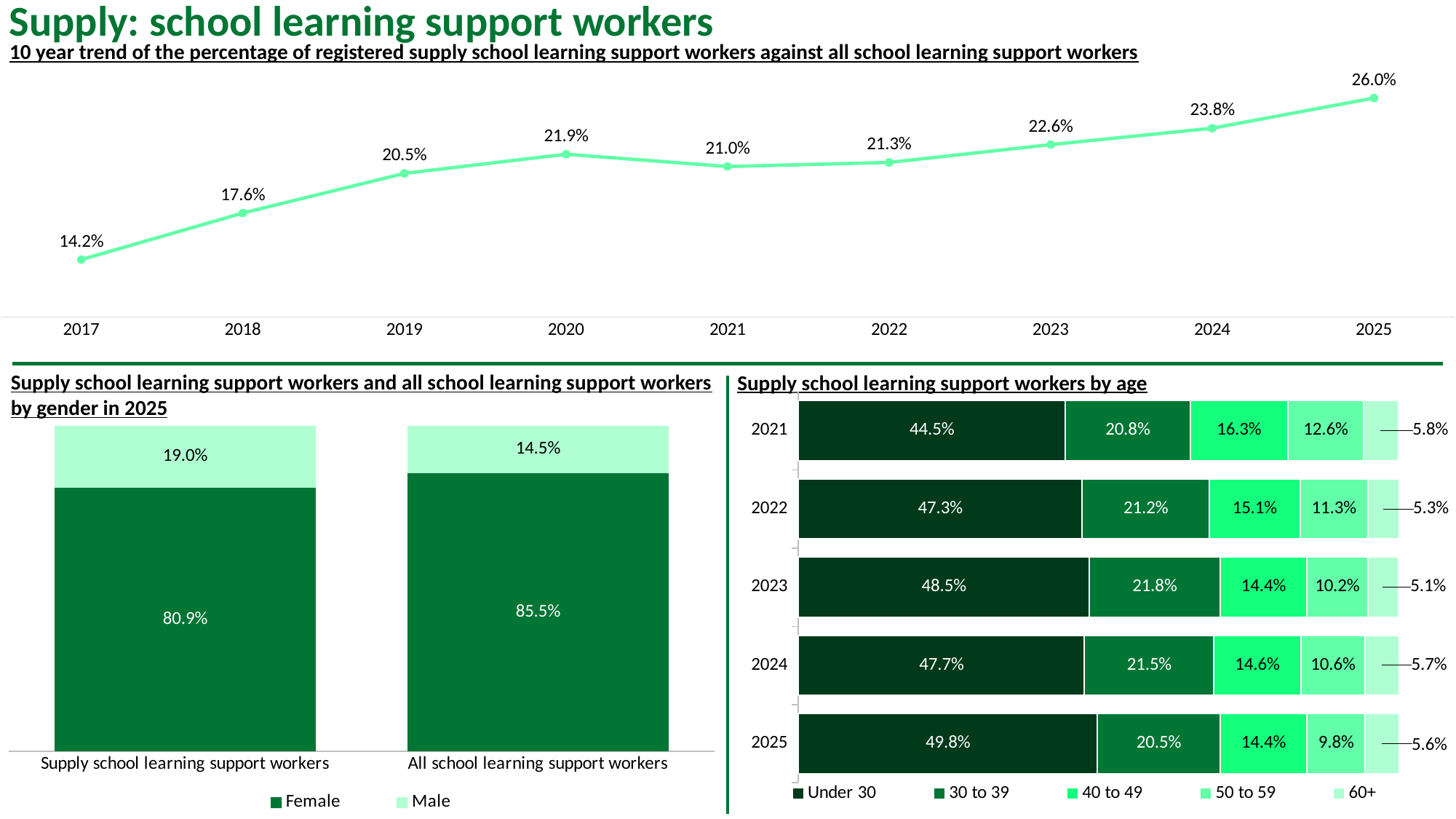
In the 10 year trend chart, which year has the lowest percentage? 2017 In the 10 year trend chart, which year has the highest percentage? 2025 In the age chart, what is the difference between the 50 to 59 share in 2021 and in 2025? 2.8 percentage points In the 10 year trend chart, how many years are plotted? 9 In the 10 year trend chart, is the value for 2021 higher or lower than the value for 2020? Lower In the gender chart, what percentage of supply school learning support workers are male in 2025? 19.0% In the gender chart, which group has the larger female share: supply school learning support workers or all school learning support workers? All school learning support workers In the 10 year trend chart, what is the difference between the 2025 value and the 2017 value? 11.8 percentage points In the age chart, what percentage of supply school learning support workers were under 30 in 2025? 49.8% What type of chart is the 10 year trend chart at the top of the slide? Line chart In the 10 year trend chart, what is the percentage of registered supply school learning support workers in 2020? 21.9% In the age chart, how many age groups does the legend list? 5